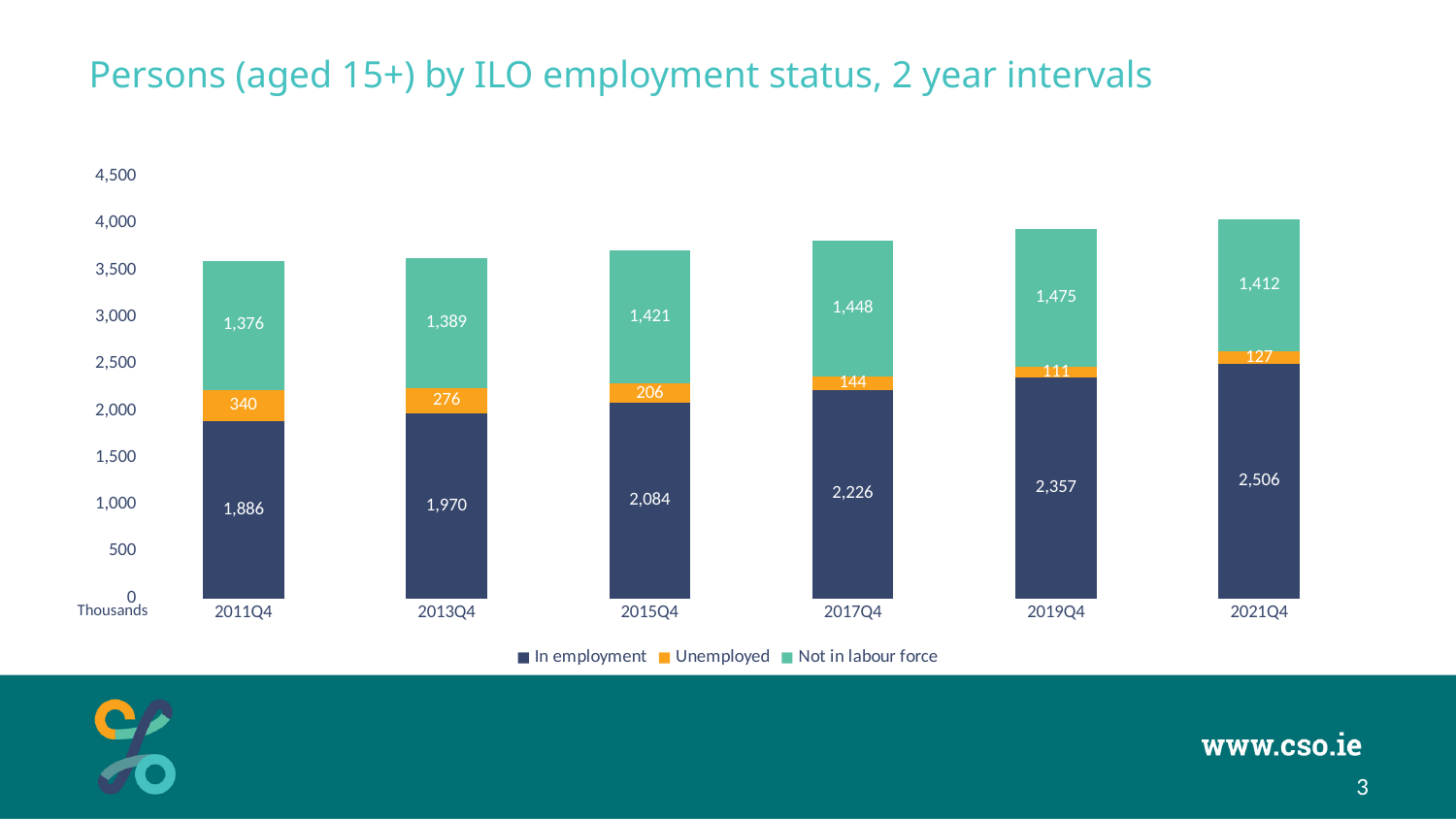
What is the value for Not in labour force in 2017Q4? 1,448 Which period has the highest In employment value? 2021Q4 What is the value for Unemployed in 2011Q4? 340 Which is larger, the Not in labour force value for 2019Q4 or for 2021Q4? 2019Q4 Which period has the lowest Unemployed value? 2019Q4 Does the In employment value rise or fall from 2011Q4 to 2021Q4? Rise What kind of chart is shown on the slide? Stacked bar chart How many periods are shown on the x axis? 6 What is the difference between the In employment values for 2021Q4 and 2011Q4? 620 What is the total of the stacked bar for 2011Q4? 3,602 What is the value for In employment in 2021Q4? 2,506 How many series does the legend list? 3